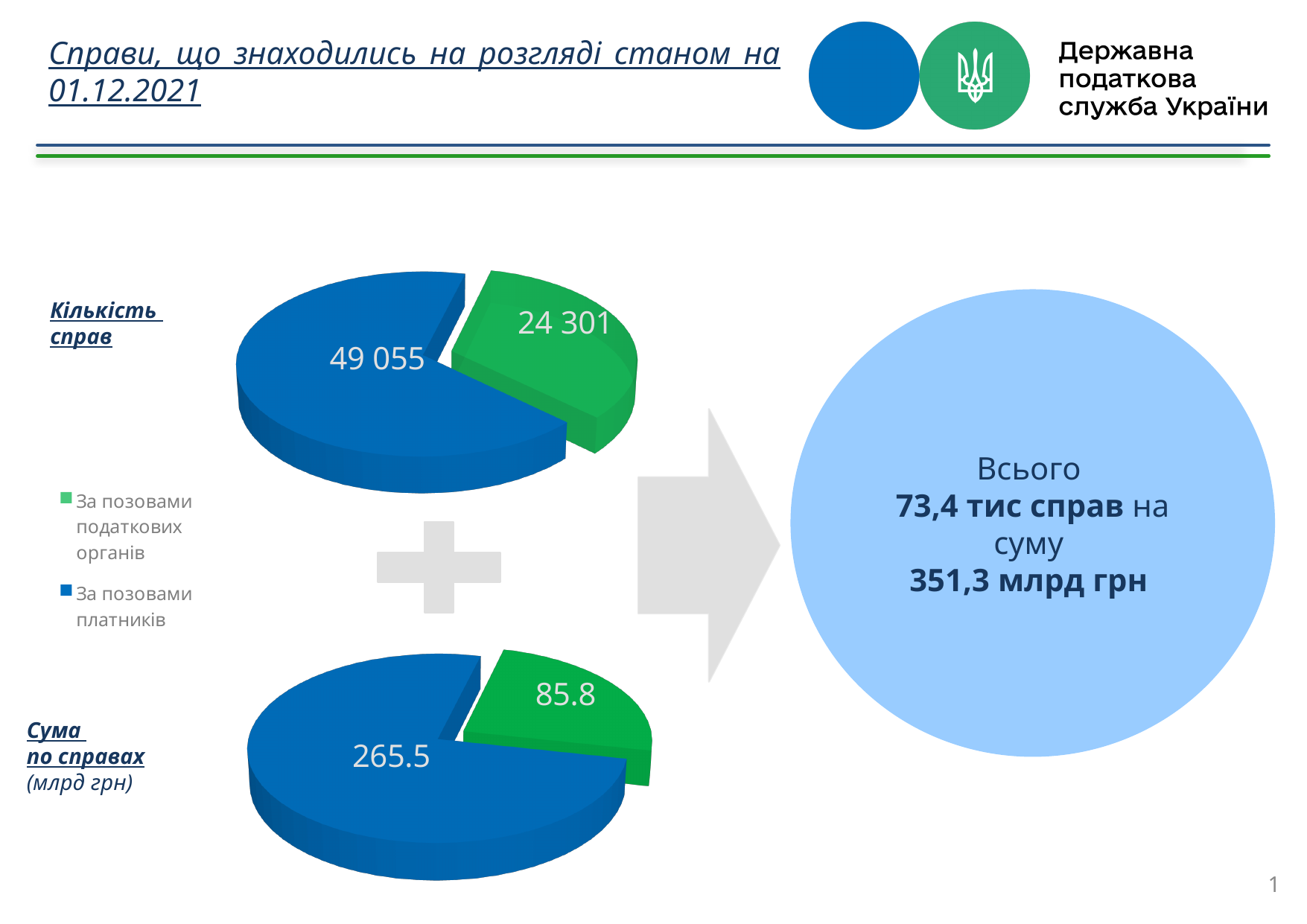
In the bottom pie chart (Сума по справах, млрд грн), what is the value for За позовами податкових органів? 85.8 Which colour represents За позовами податкових органів in the pie charts? Green How many entries does the legend list? 2 In the bottom pie chart (Сума по справах), which category has the smaller slice? За позовами податкових органів In the top pie chart (Кількість справ), what is the difference between the value for За позовами платників and the value for За позовами податкових органів? 24 754 What type of chart is used for Кількість справ? Pie chart In the bottom pie chart (Сума по справах), what is the difference between the value for За позовами платників and the value for За позовами податкових органів? 179.7 In the top pie chart (Кількість справ), which category has the larger slice? За позовами платників In the top pie chart (Кількість справ), what is the value for За позовами платників? 49 055 In the bottom pie chart (Сума по справах, млрд грн), what is the value for За позовами платників? 265.5 How many slices does the bottom pie chart (Сума по справах) have? 2 In the top pie chart (Кількість справ), what is the value for За позовами податкових органів? 24 301